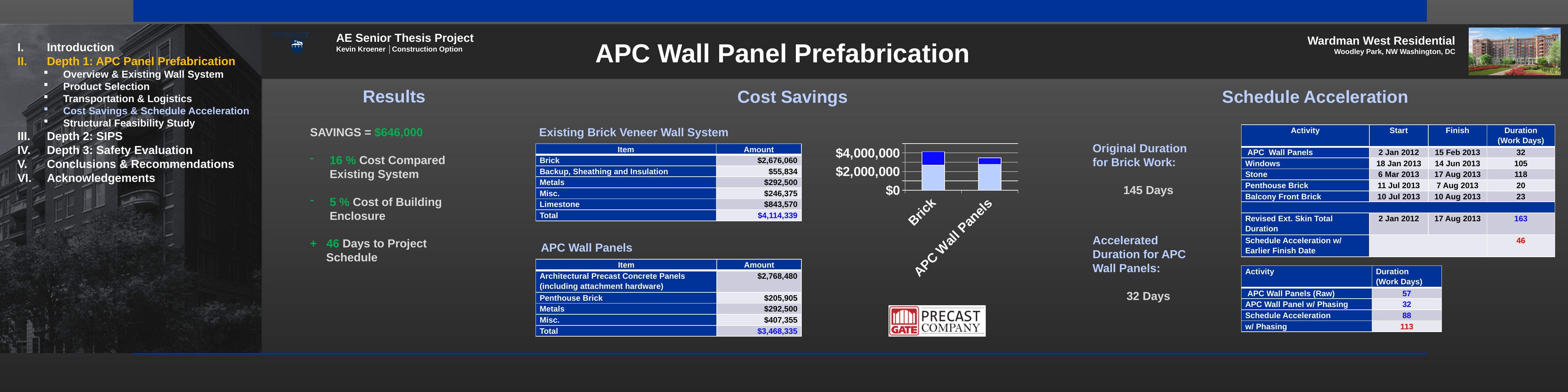
What is the highest value labelled on the y axis of the cost chart? $4,000,000 How many categories are plotted on the x axis of the cost chart? 2 Do the bar heights in the cost chart rise or fall from Brick to APC Wall Panels? fall Which category in the cost chart has the taller bar? Brick Is the total value for APC Wall Panels in the cost chart greater or less than $2,000,000? greater What kind of chart is shown in the Cost Savings section? bar chart Which category in the cost chart has the shorter bar? APC Wall Panels Is the total value for Brick in the cost chart greater or less than $2,000,000? greater How many coloured segments make up each bar in the cost chart? 2 In the cost chart, is the bar for Brick taller or shorter than the bar for APC Wall Panels? taller Is the total value for APC Wall Panels in the cost chart greater or less than $4,000,000? less